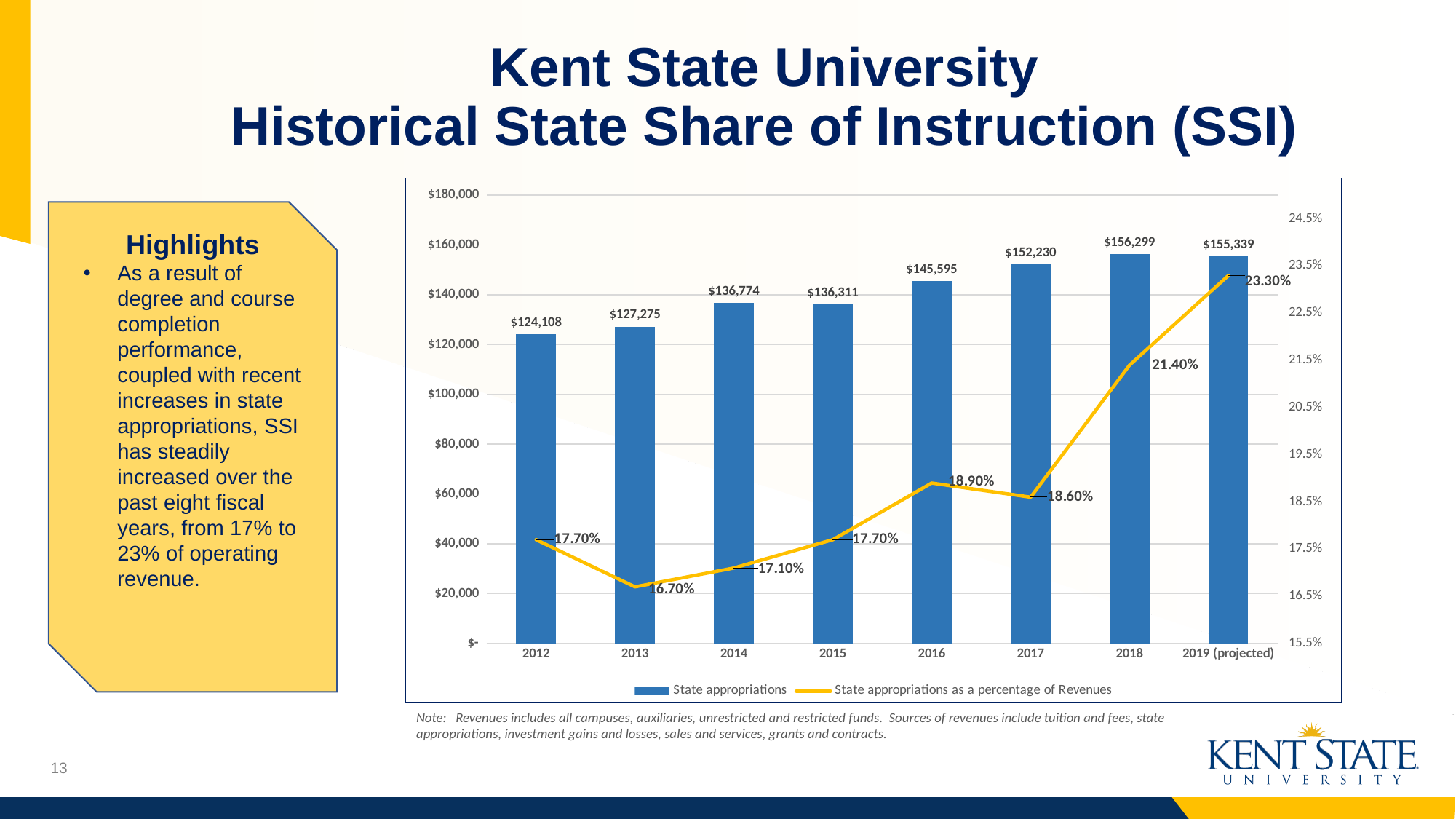
What kind of chart is used for the State appropriations series? bar chart Which year has the highest State appropriations? 2018 Which year has the lowest State appropriations as a percentage of Revenues? 2013 Does State appropriations as a percentage of Revenues rise or fall from 2017 to 2019 (projected)? rise What colour is the line for State appropriations as a percentage of Revenues? yellow What is the difference in State appropriations between 2018 and 2012? $32,191 What is the value of State appropriations for 2016? $145,595 Which is larger, State appropriations for 2014 or for 2015? 2014 How many series does the legend list? 2 What is State appropriations as a percentage of Revenues for 2019 (projected)? 23.30% Is the value of State appropriations for 2013 greater or less than $140,000? less How many years are shown on the x axis? 8